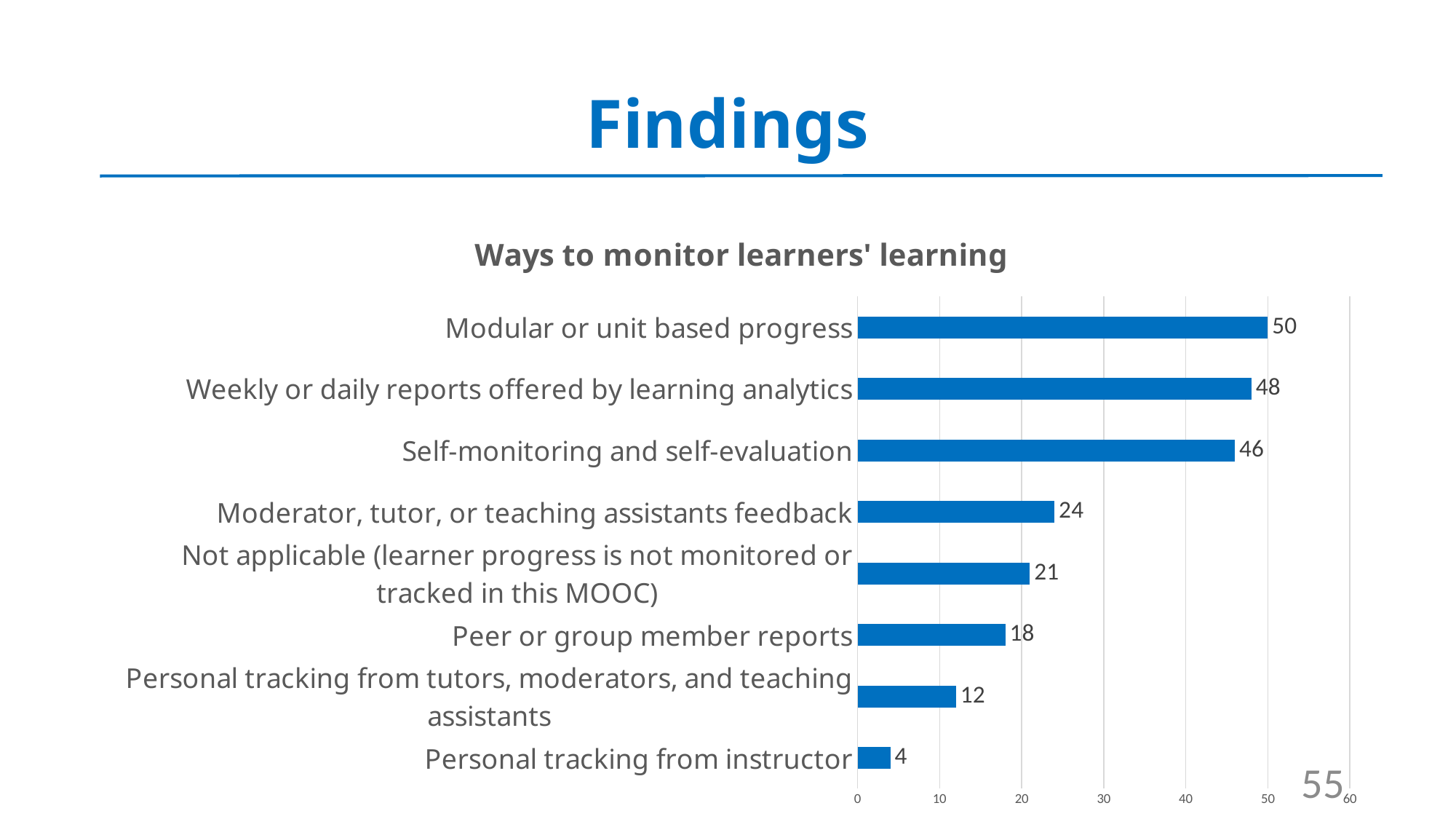
What is the value for Modular or unit based progress? 50 Which category has the lowest value? Personal tracking from instructor What is the difference between the values for Moderator, tutor, or teaching assistants feedback and Personal tracking from tutors, moderators, and teaching assistants? 12 What is the title of the chart? Ways to monitor learners' learning What is the value for Peer or group member reports? 18 Which is larger: the value for Not applicable (learner progress is not monitored or tracked in this MOOC) or the value for Peer or group member reports? Not applicable (learner progress is not monitored or tracked in this MOOC) Which category has the highest value? Modular or unit based progress How many categories are shown in the chart? 8 What is the value for Self-monitoring and self-evaluation? 46 What kind of chart is shown on the slide? Bar chart What is the value for Personal tracking from instructor? 4 What is the difference between the values for Modular or unit based progress and Weekly or daily reports offered by learning analytics? 2